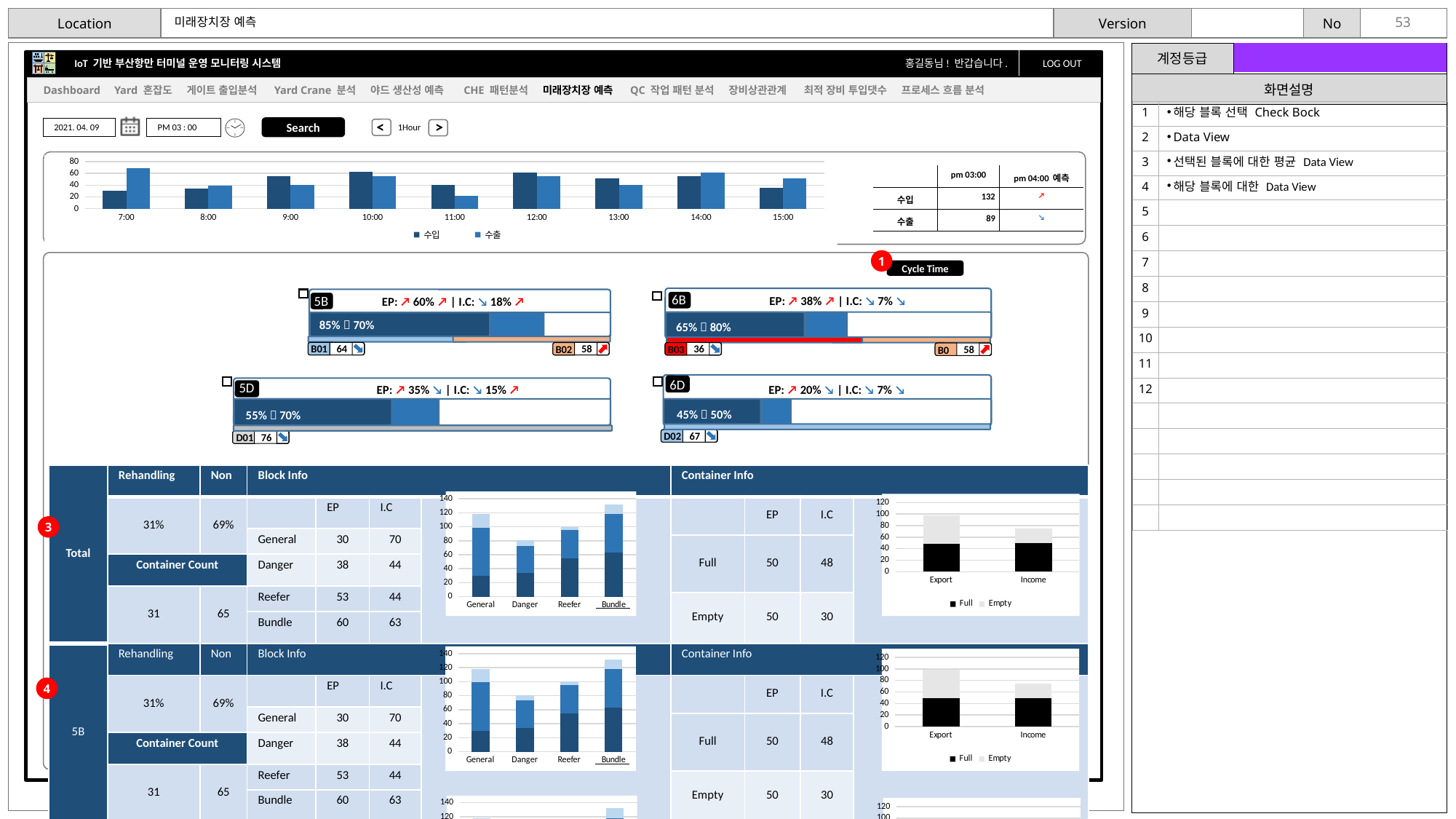
In the top hourly chart, what are the two legend entries? 수입, 수출 In the Container Info chart of the Total row, which bar is taller, Export or Income? Export In the top hourly chart, how many time categories are shown on the x axis? 9 What kind of chart is the chart at the top of the slide showing hourly values from 7:00 to 15:00? bar chart In the Container Info chart of the Total row, how many series does the legend list? 2 In the top hourly chart, is the 수입 value at 7:00 greater or less than 40? less In the top hourly chart, at which time is the 수출 bar highest? 7:00 In the Block Info stacked bar chart of the Total row, is the total for Danger greater or less than 100? less In the top hourly chart, how many series does the legend list? 2 In the top hourly chart, is the 수출 value at 7:00 greater or less than 60? greater In the Block Info stacked bar chart of the Total row, how many categories are on the x axis? 4 In the Block Info stacked bar chart of the Total row, which category has the tallest bar? Bundle